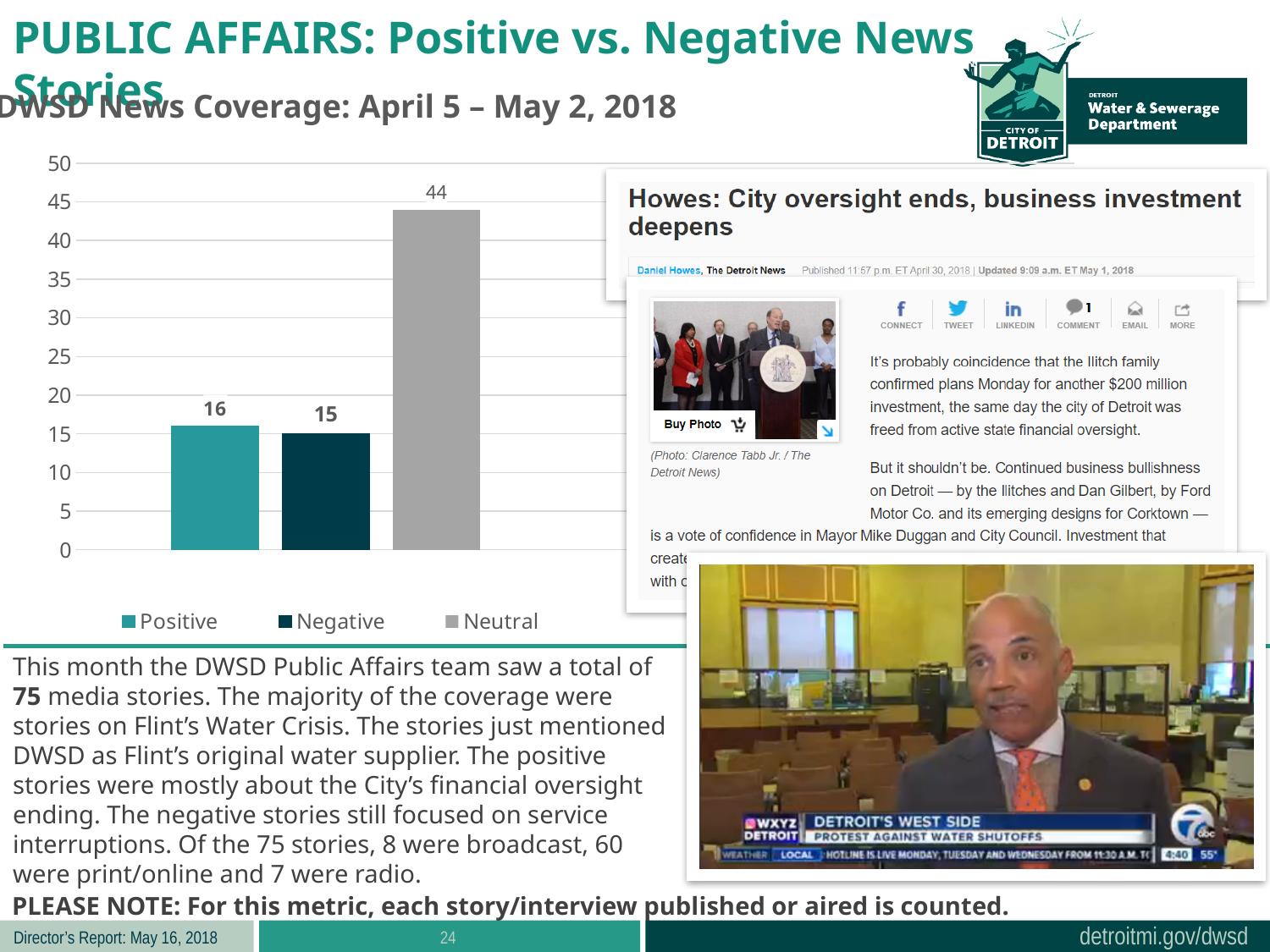
How many series does the legend list? 3 Which is larger, the Neutral value or the Negative value? Neutral What colour is the Neutral bar? Gray What is the difference between the Neutral and Positive values? 28 Is the value for Neutral greater or less than 40? greater Which category has the lowest value? Negative Which category has the highest value? Neutral What kind of chart is shown on the slide? Bar chart What is the difference between the Positive and Negative values? 1 What is the value for Positive news stories? 16 What is the value for Negative news stories? 15 What is the value for Neutral news stories? 44